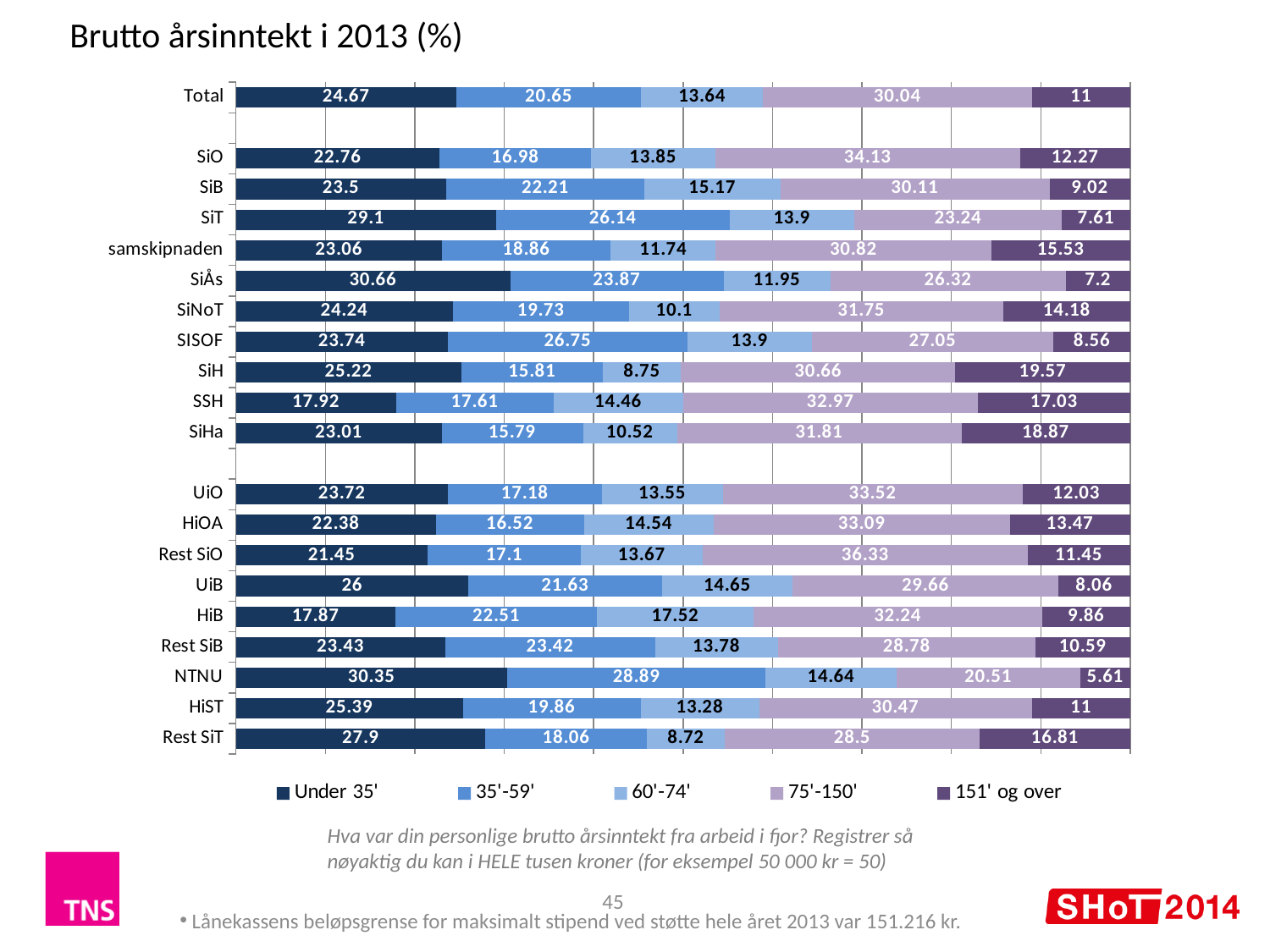
What is the total of the stacked bar for Total? 100 How many series does the legend list? 5 What is the value for Total in the Under 35' series? 24.67 What is the difference between the 75'-150' value and the 151' og over value for Total? 19.04 Which category has the highest value in the 75'-150' series? Rest SiO How many categories are shown on the y axis? 20 What is the value for Rest SiO in the 75'-150' series? 36.33 Which category has the lowest value in the 151' og over series? NTNU What kind of chart is shown on the slide? Stacked bar chart Which is larger in the 35'-59' series: UiB or HiB? HiB What is the value for SiH in the 151' og over series? 19.57 What is the value for NTNU in the 35'-59' series? 28.89